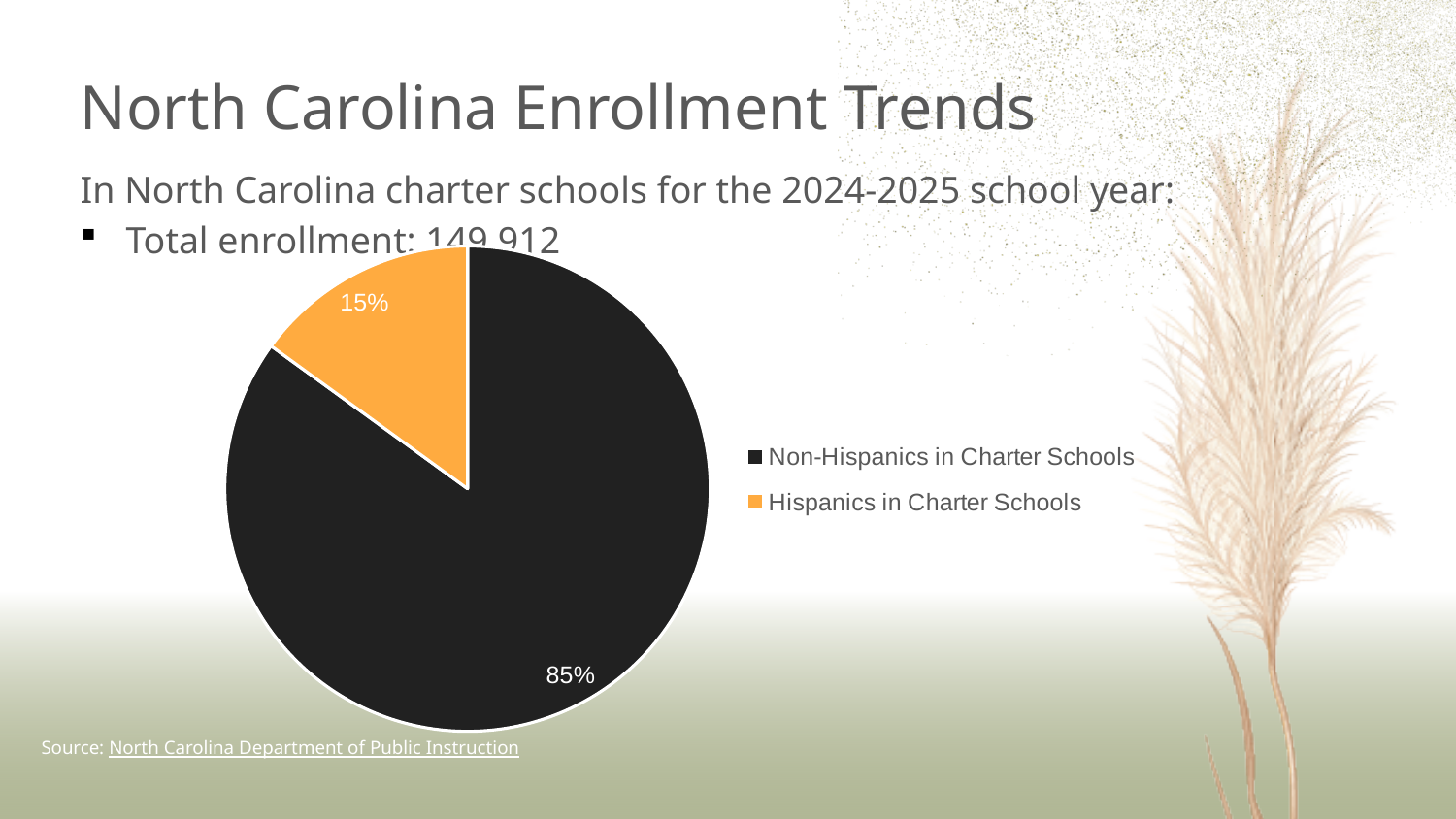
What share of the pie is Hispanics in Charter Schools? 15% What is the difference in percentage points between the Non-Hispanics and Hispanics slices? 70 What share of the pie is Non-Hispanics in Charter Schools? 85% Which slice of the pie is the largest? Non-Hispanics in Charter Schools Which slice of the pie is the smallest? Hispanics in Charter Schools How many slices does the pie chart have? 2 How many entries does the legend list? 2 What kind of chart is shown on the slide? pie chart What colour is the Non-Hispanics in Charter Schools slice? black What colour is the Hispanics in Charter Schools slice? orange Which is larger: the Hispanics in Charter Schools slice or the Non-Hispanics in Charter Schools slice? Non-Hispanics in Charter Schools